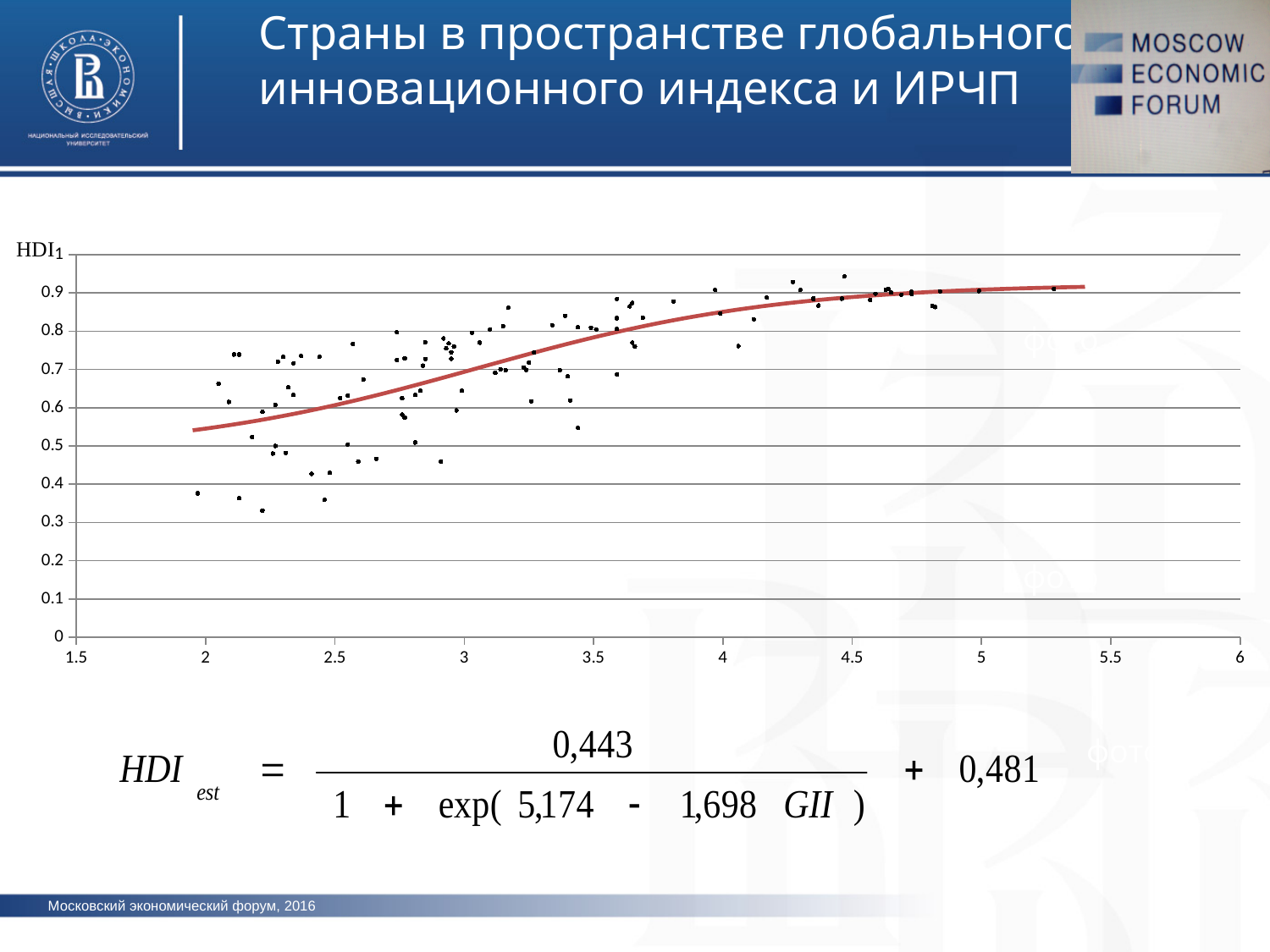
What kind of chart is shown on the slide? scatter chart What is the highest tick value shown on the horizontal axis? 6 Is the fitted red curve higher at x = 4.5 or at x = 2.5? x = 4.5 Do the values of the fitted red curve rise or fall as the x axis increases from 2 to 5.5? rise What is the label on the vertical axis of the chart? HDI Is the value of the fitted red curve at x = 2 greater or less than 0.5? greater Is the value of the fitted red curve at x = 5 greater or less than 0.8? greater Is the value of the fitted red curve at x = 4 greater or less than 0.8? greater